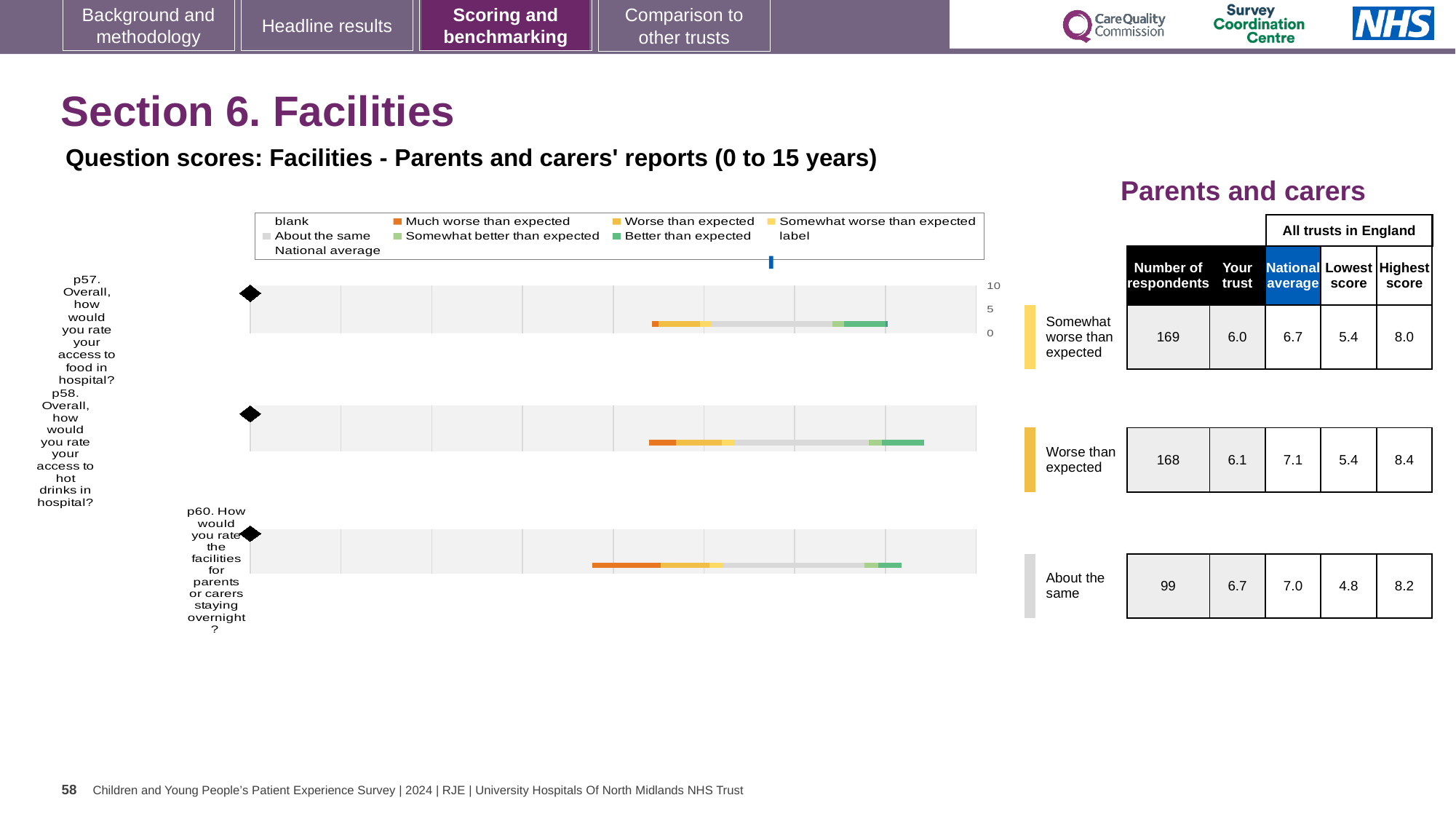
Which benchmark category is p58 (access to hot drinks in hospital) assigned to? Worse than expected What is the 'Your trust' score for p57 (access to food in hospital)? 6.0 What is the 'Your trust' score for p60 (facilities for parents or carers staying overnight)? 6.7 How many respondents answered p57 (access to food in hospital)? 169 What is the highest score among all trusts in England for p58 (access to hot drinks in hospital)? 8.4 What kind of chart is used to show the question scores for Facilities? Bar chart What is the difference between the national average and the 'Your trust' score for p58 (access to hot drinks in hospital)? 1.0 What is the national average score for p58 (access to hot drinks in hospital)? 7.1 How many questions (categories) are plotted in the Facilities chart? 3 Is the 'Your trust' score for p57 (access to food in hospital) larger or smaller than the national average for that question? Smaller Which of the three questions has the highest 'Your trust' score? p60. How would you rate the facilities for parents or carers staying overnight? What is the lowest score among all trusts in England for p60 (facilities for parents or carers staying overnight)? 4.8